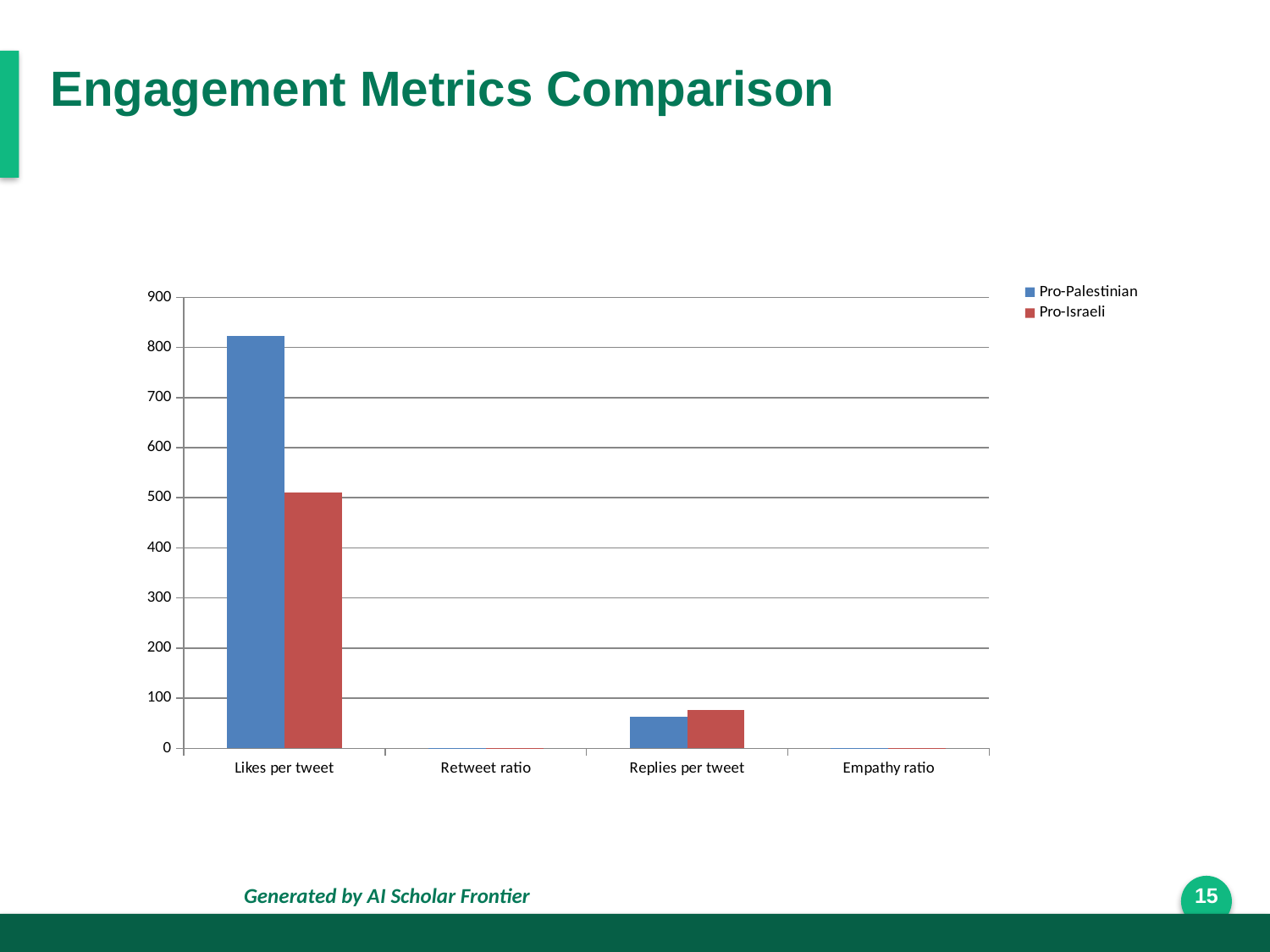
Is the Pro-Israeli value for Likes per tweet greater or less than 600? less What is the title of the slide containing the chart? Engagement Metrics Comparison Which category has the highest Pro-Palestinian value? Likes per tweet How many categories are shown on the x axis? 4 What kind of chart is shown on the slide? bar chart For Replies per tweet, which series has the larger value, Pro-Palestinian or Pro-Israeli? Pro-Israeli Is the Pro-Palestinian value for Replies per tweet greater or less than 100? less Which colour represents the Pro-Israeli series in the legend? red Is the Pro-Palestinian value for Likes per tweet greater or less than 700? greater How many series does the legend list? 2 Which category has the highest Pro-Israeli value? Likes per tweet For Likes per tweet, which series has the larger value, Pro-Palestinian or Pro-Israeli? Pro-Palestinian